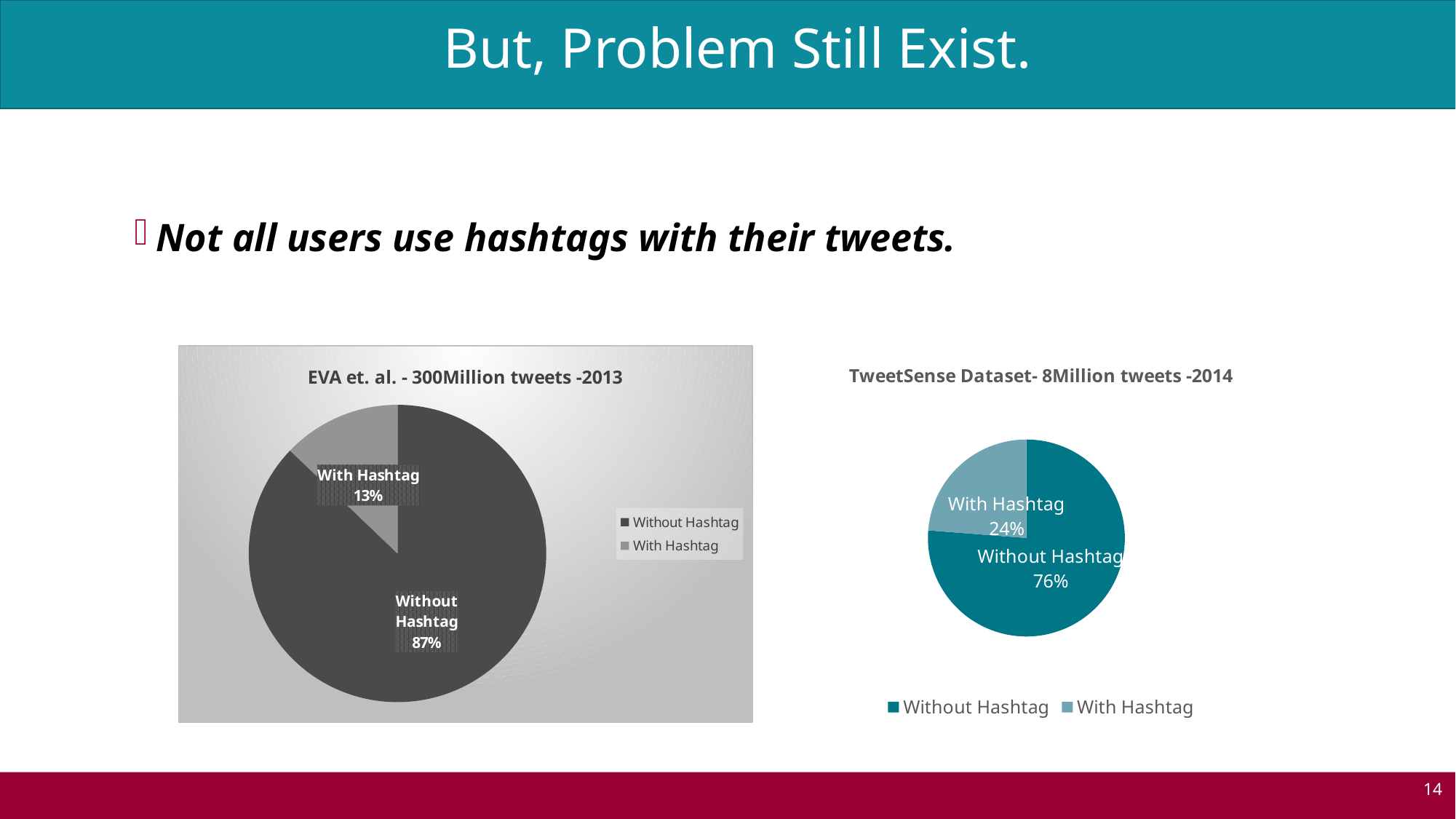
In the 'EVA et. al. - 300Million tweets -2013' chart, what share of tweets are With Hashtag? 13% Which chart shows a larger With Hashtag share, the EVA et. al. 2013 chart or the TweetSense 2014 chart? TweetSense Dataset- 8Million tweets -2014 In the 'EVA et. al. - 300Million tweets -2013' chart, what share of tweets are Without Hashtag? 87% In the 'EVA et. al. - 300Million tweets -2013' chart, what is the difference between the Without Hashtag and With Hashtag shares? 74% In the 'EVA et. al. - 300Million tweets -2013' chart, which slice is the largest? Without Hashtag In the 'TweetSense Dataset- 8Million tweets -2014' chart, what share of tweets are With Hashtag? 24% What kind of chart is the 'TweetSense Dataset- 8Million tweets -2014' chart? Pie chart How many entries does the legend of the 'TweetSense Dataset- 8Million tweets -2014' chart list? 2 In the 'TweetSense Dataset- 8Million tweets -2014' chart, which slice is the smallest? With Hashtag How many slices does the 'EVA et. al. - 300Million tweets -2013' pie chart have? 2 In the 'TweetSense Dataset- 8Million tweets -2014' chart, what is the difference between the Without Hashtag and With Hashtag shares? 52%